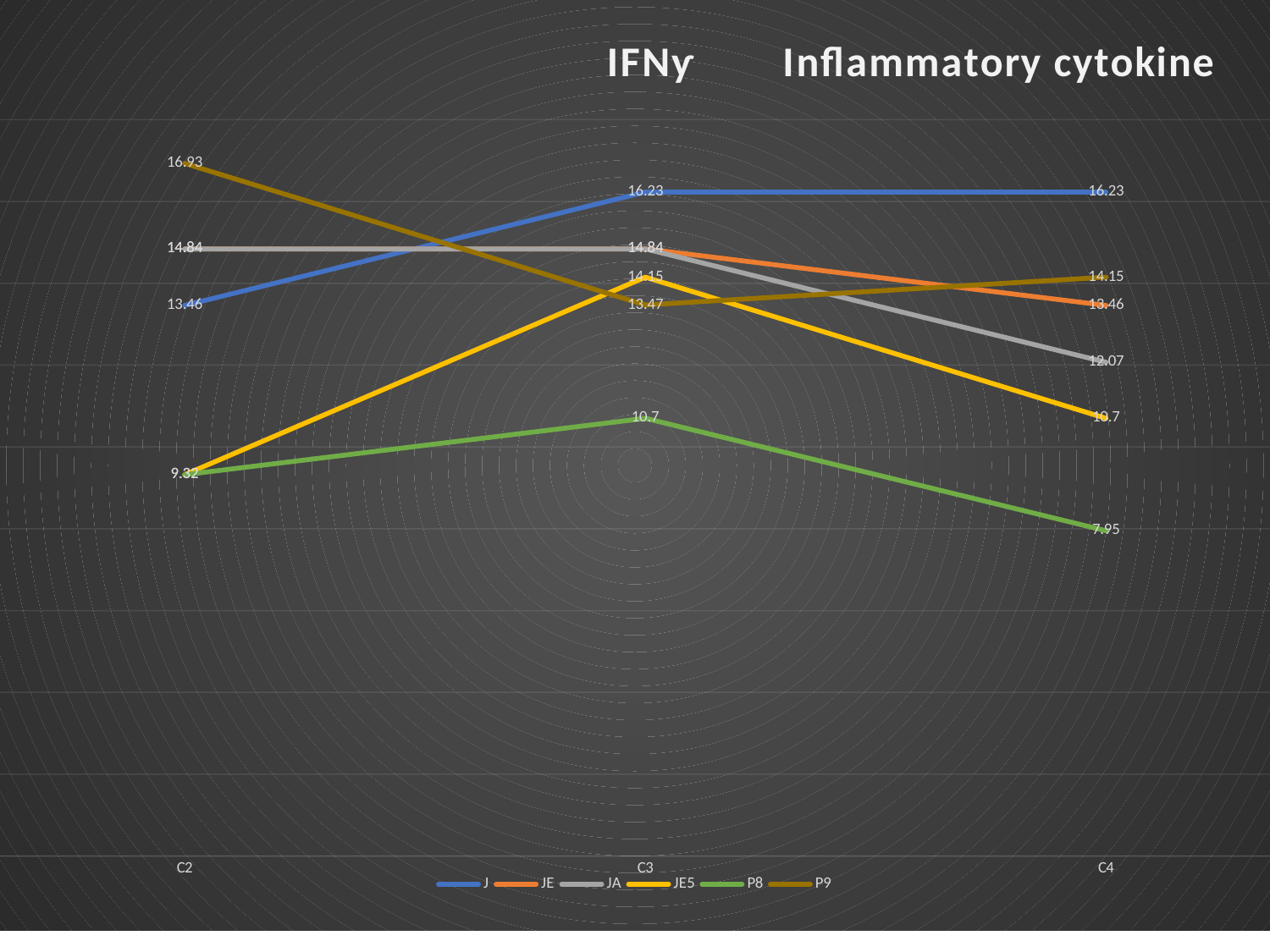
Does the value for P8 rise or fall from C3 to C4? fall What is the value for J at C3? 16.23 What is the difference between the value for J at C3 and the value for J at C2? 2.77 How many categories are shown on the x axis? 3 Which is larger at C3, the value for JE5 or the value for P9? JE5 What is the value for P9 at C2? 16.93 What is the value for JA at C4? 12.07 What is the value for P8 at C4? 7.95 Which series has the lowest value at C4? P8 How many series does the legend list? 6 Which series has the highest value at C2? P9 What kind of chart is shown on the slide? line chart